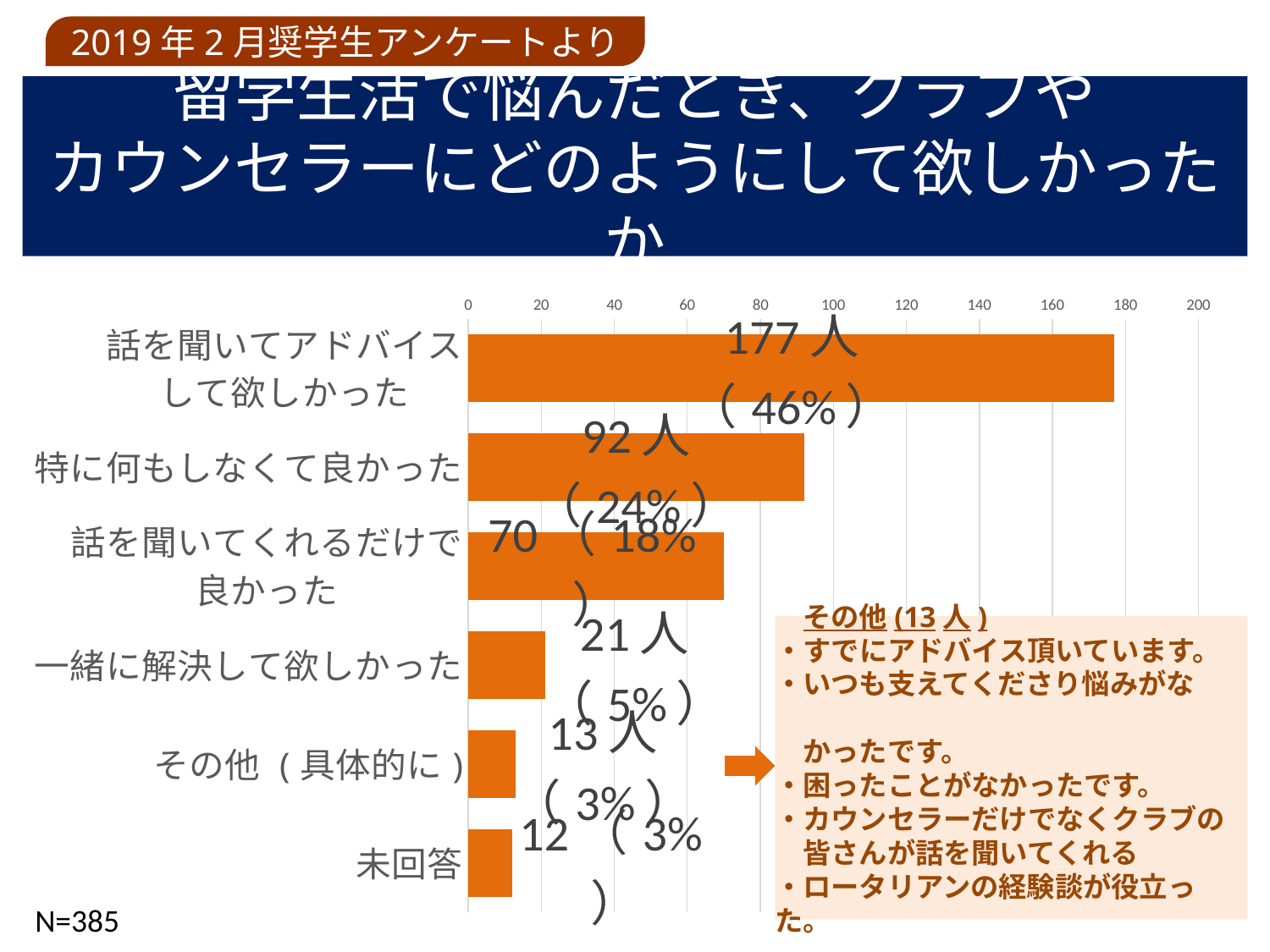
What is the value for 一緒に解決して欲しかった? 21人 Which category has the lowest value? 未回答 What is the value for 話を聞いてくれるだけで良かった? 70 Which is larger, the value for 特に何もしなくて良かった or the value for 話を聞いてくれるだけで良かった? 特に何もしなくて良かった What kind of chart is shown on the slide? bar chart What is the difference between the values for 話を聞いてアドバイスして欲しかった and 特に何もしなくて良かった? 85 Is the value for 話を聞いてアドバイスして欲しかった greater or less than 160? greater How many categories does the bar chart show? 6 What percentage is shown for その他（具体的に）? 3% Which category has the highest value? 話を聞いてアドバイスして欲しかった What is the value for 特に何もしなくて良かった? 92人 What is the value for 話を聞いてアドバイスして欲しかった? 177人